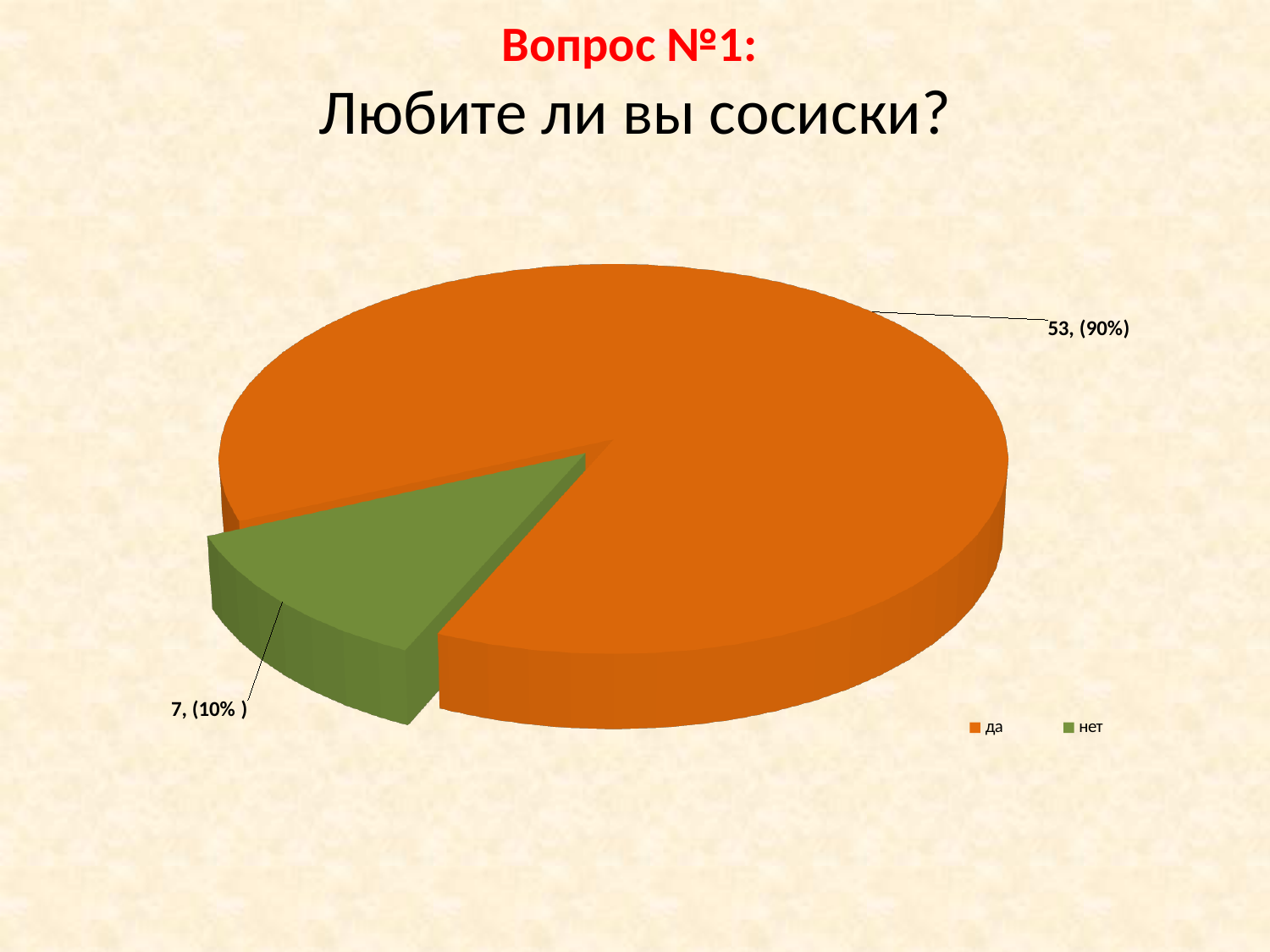
Which category has the smallest slice? нет What share of the pie does "нет" represent? 10% Which is larger, the value for "да" or the value for "нет"? да How many entries does the legend list? 2 What share of the pie does "да" represent? 90% What colour is the "нет" slice? green What is the count for "нет"? 7 Which category has the largest slice? да What is the count for "да"? 53 What kind of chart is shown on the slide? pie chart How many slices does the pie chart have? 2 What is the difference between the counts for "да" and "нет"? 46